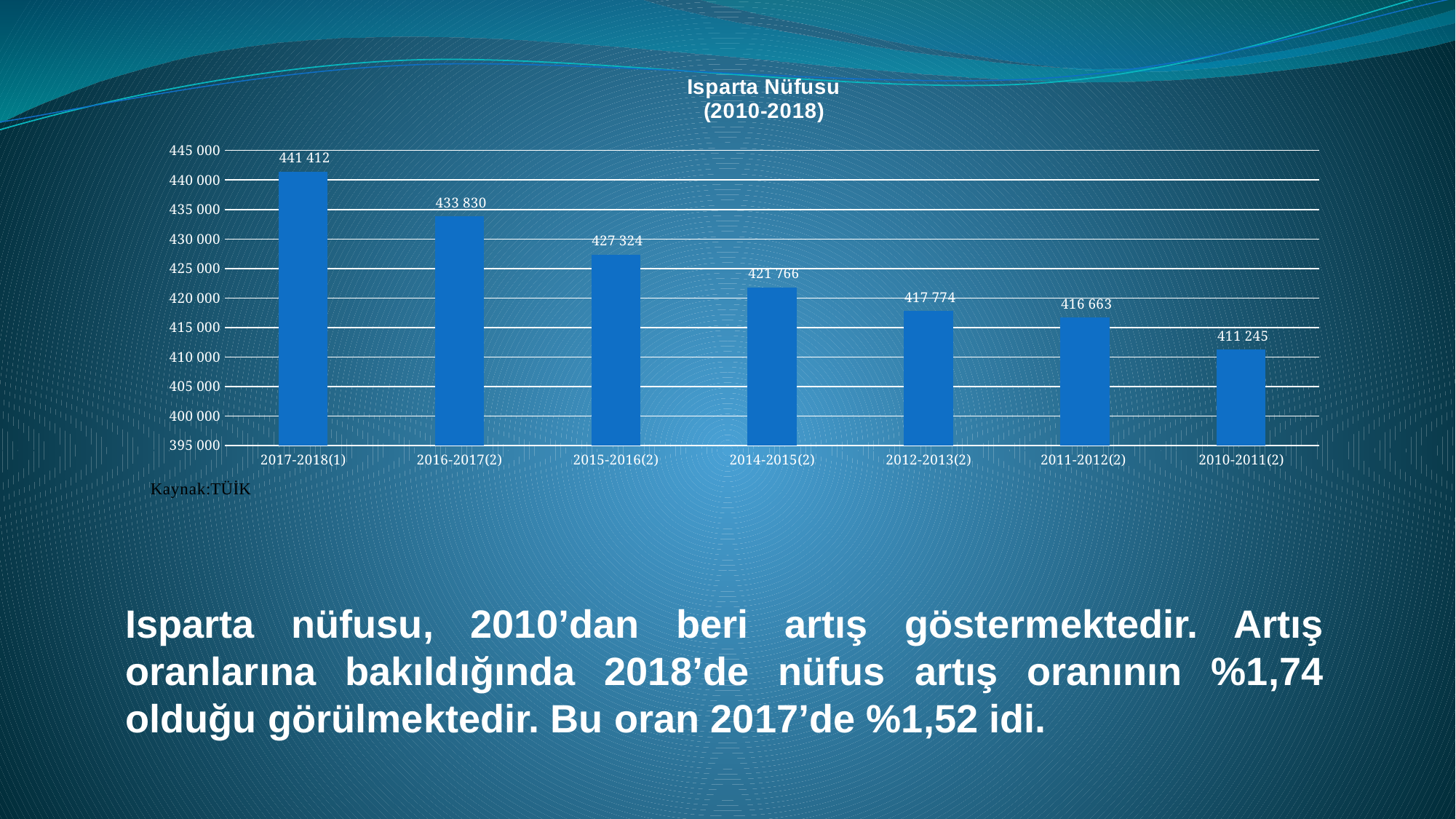
What kind of chart is shown on the slide? bar chart What is the value for 2012-2013(2)? 417 774 Which is larger, the value for 2015-2016(2) or the value for 2011-2012(2)? 2015-2016(2) What is the difference between the values for 2016-2017(2) and 2015-2016(2)? 6 506 What is the value for 2017-2018(1)? 441 412 Do the values rise or fall from left to right along the x axis? fall What is the value for 2010-2011(2)? 411 245 How many categories are shown on the x axis? 7 What is the difference between the values for 2017-2018(1) and 2010-2011(2)? 30 167 Which category has the highest value? 2017-2018(1) Which category has the lowest value? 2010-2011(2) What is the value for 2014-2015(2)? 421 766